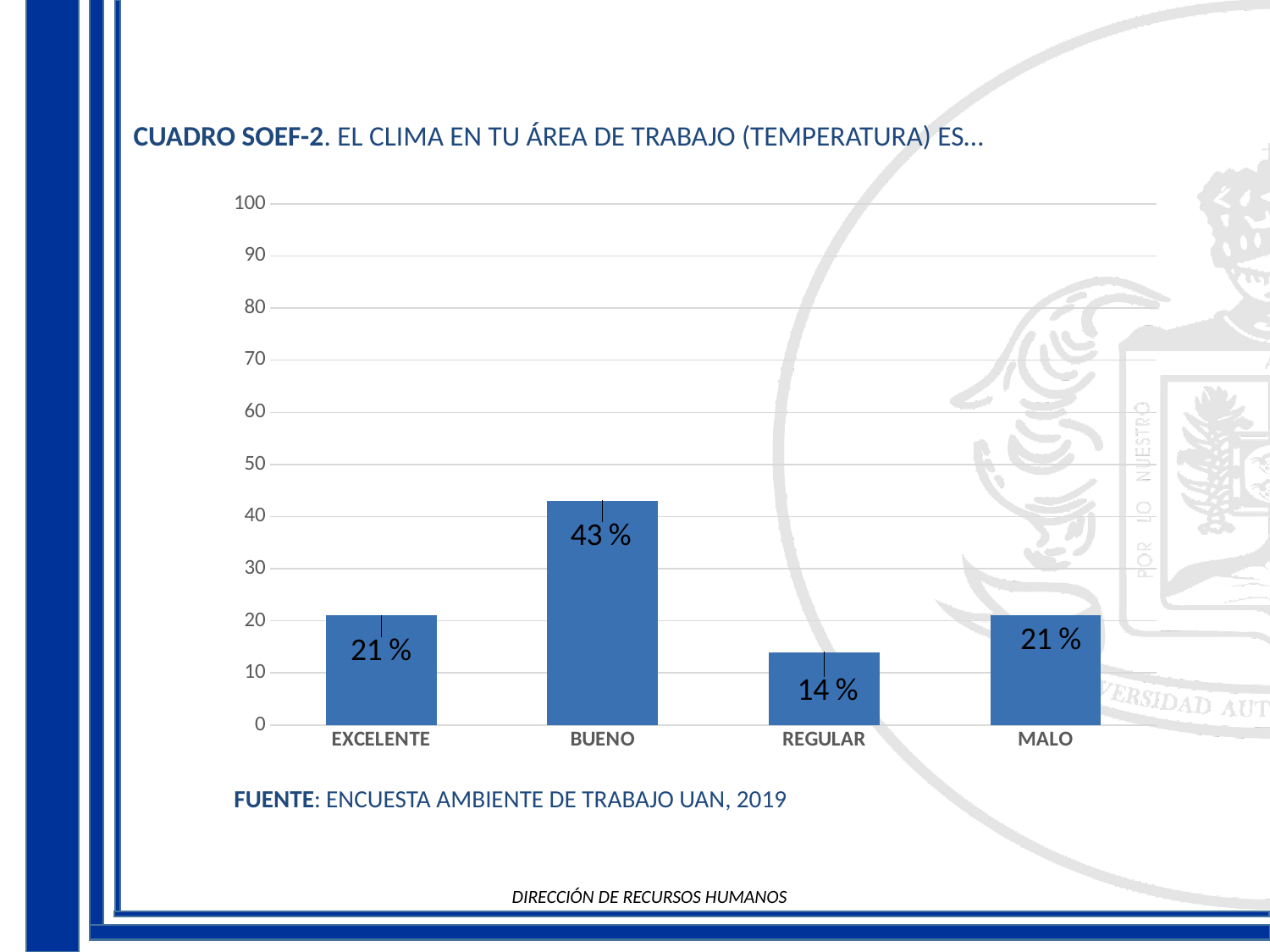
Which is larger, the value for EXCELENTE or the value for REGULAR? EXCELENTE What is the value for BUENO? 43 % Which category has the highest value? BUENO What kind of chart is shown on the slide? bar chart Is the value for BUENO greater or less than 50? less What is the value for REGULAR? 14 % What is the difference between the values for BUENO and MALO? 22 % What is the difference between the values for BUENO and REGULAR? 29 % What is the value for EXCELENTE? 21 % Which category has the lowest value? REGULAR What is the source cited below the chart? ENCUESTA AMBIENTE DE TRABAJO UAN, 2019 How many categories are shown on the x axis? 4